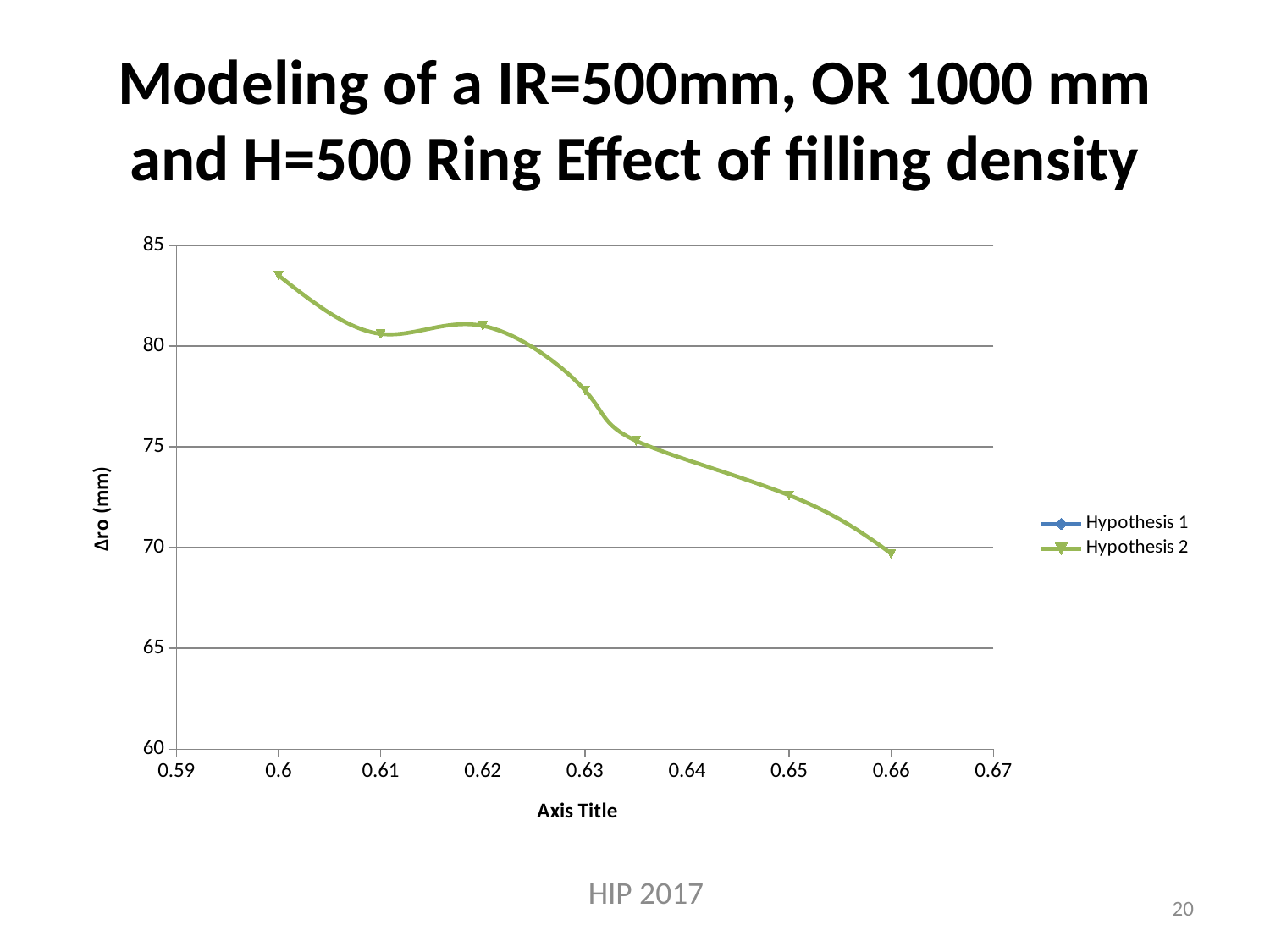
What is the label of the vertical axis? Δro (mm) Is the Hypothesis 2 value at x = 0.6 greater or less than 80? greater What kind of chart is shown on the slide? line chart Do the Hypothesis 2 values generally rise or fall as the x-axis value increases? fall Which has the larger Hypothesis 2 value, x = 0.63 or x = 0.65? 0.63 Is the Hypothesis 2 value at x = 0.65 greater or less than 75? less What are the names of the series listed in the legend? Hypothesis 1 and Hypothesis 2 How many data points are plotted on the Hypothesis 2 line? 7 Is the Hypothesis 2 value at x = 0.63 greater or less than 75? greater How many series does the legend list? 2 At which x value is the Hypothesis 2 line highest? 0.6 At which x value is the Hypothesis 2 line lowest? 0.66